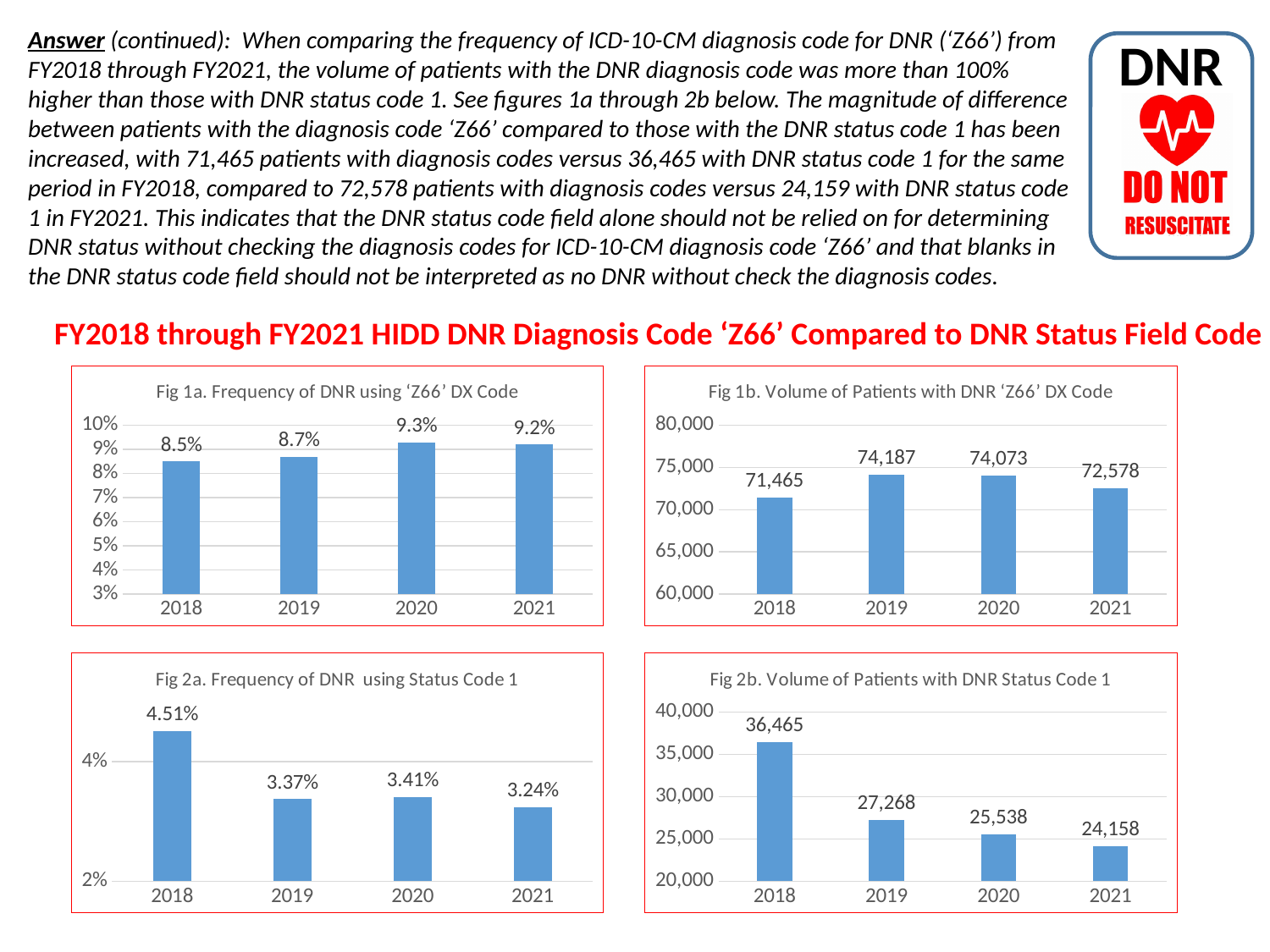
In Fig 2b, how many years are shown on the x axis? 4 In Fig 2b, what is the difference between the 2018 and 2021 volumes of patients with DNR Status Code 1? 12,307 What type of chart is Fig 2a? Bar chart In Fig 1b, which year has the highest volume of patients with the DNR 'Z66' DX code? 2019 In Fig 1b, what is the volume of patients with the DNR 'Z66' DX code in 2018? 71,465 What is the title of the chart in the bottom-right of the slide? Fig 2b. Volume of Patients with DNR Status Code 1 In Fig 2b, do the values rise or fall from 2018 to 2021? Fall In Fig 1a, what is the frequency of DNR using the 'Z66' DX code in 2020? 9.3% In Fig 1a, which year has the higher frequency, 2018 or 2021? 2021 In Fig 2a, which year has the lowest frequency of DNR using Status Code 1? 2021 In Fig 2a, what is the frequency of DNR using Status Code 1 in 2021? 3.24% In Fig 2b, what is the volume of patients with DNR Status Code 1 in 2019? 27,268